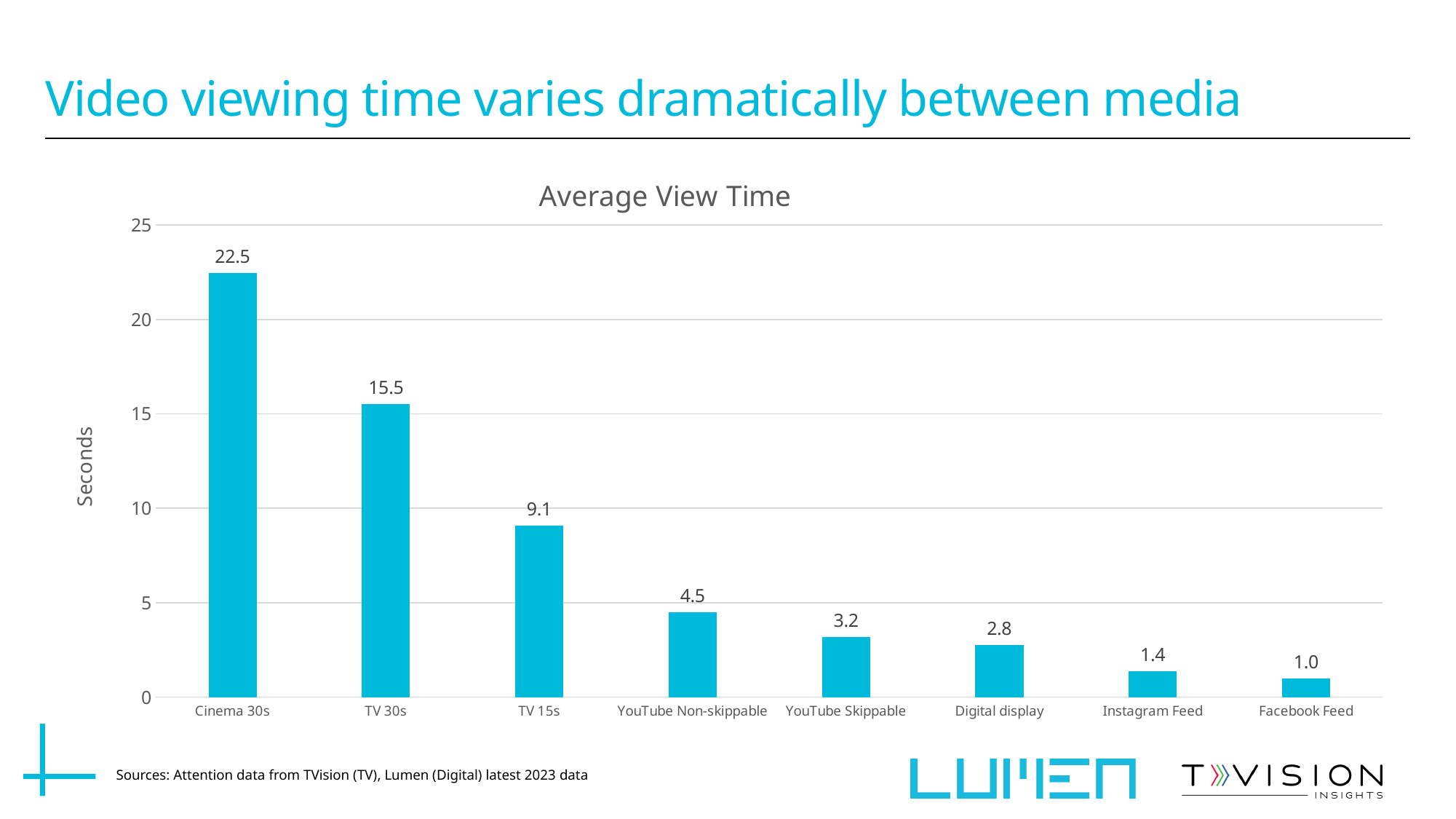
Which category has the highest average view time? Cinema 30s Do the values rise or fall moving from left to right along the x axis? Fall What is the average view time for Cinema 30s? 22.5 What is the difference in average view time between TV 30s and TV 15s? 6.4 What is the title of the chart? Average View Time How many categories are shown on the chart? 8 Which category has the lowest average view time? Facebook Feed Which has a higher average view time, YouTube Skippable or Digital display? YouTube Skippable What is the difference in average view time between Cinema 30s and TV 30s? 7.0 What is the average view time for YouTube Non-skippable? 4.5 What kind of chart is shown on the slide? Bar chart What is the average view time for Instagram Feed? 1.4